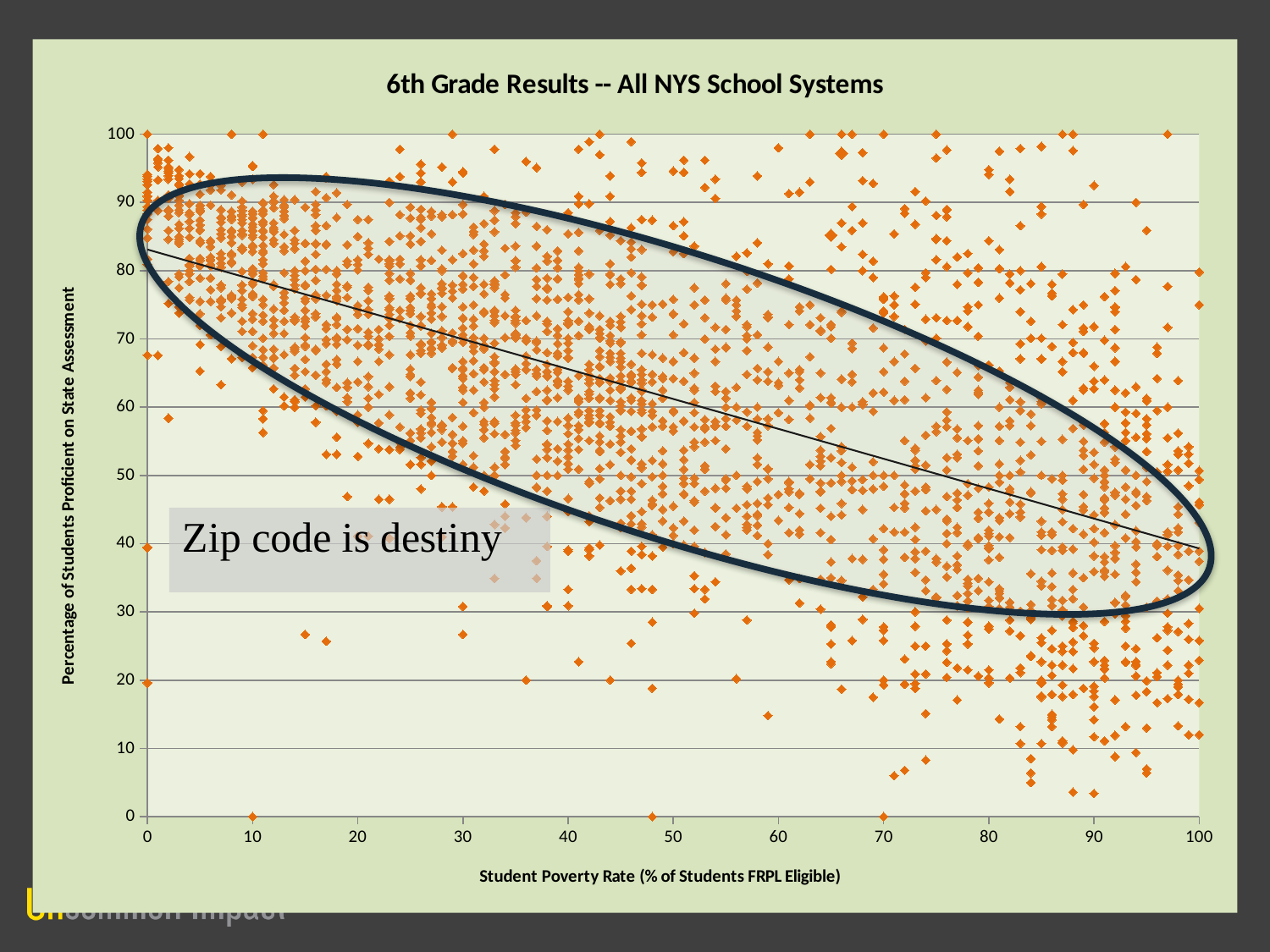
What is the title of the chart? 6th Grade Results -- All NYS School Systems What is the interval between consecutive tick marks on the y axis? 10 What is the highest value shown on the x axis? 100 What is the highest value shown on the y axis? 100 Does the trend line drawn through the points slope upward or downward from left to right? Downward How many labelled tick marks are there on the x axis, from 0 to 100? 11 What text is written in the annotation box placed over the chart? Zip code is destiny As the student poverty rate increases along the x axis, do the percentages of students proficient generally rise or fall? Fall What kind of chart is shown on the slide? Scatter plot